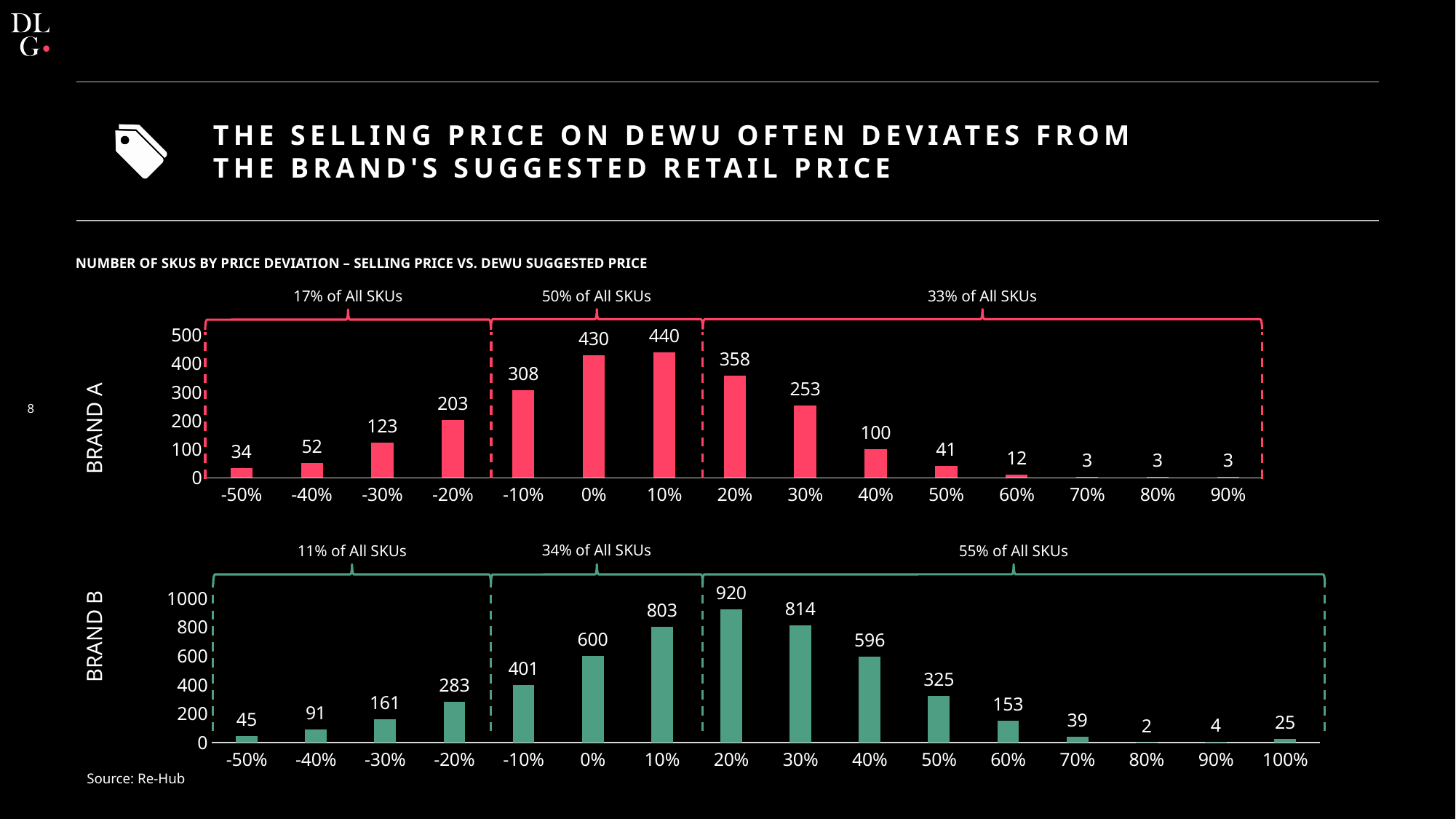
In the Brand B chart, what is the difference between the number of SKUs at 10% and at 0%? 203 In the Brand A chart, which is larger: the number of SKUs at -20% or at 30%? 30% In the Brand B chart, how many SKUs are at the 20% price deviation? 920 In the Brand A chart, which price deviation category has the highest number of SKUs? 10% In the Brand A chart, is the value for 20% greater or less than 300? greater What colour are the bars in the Brand B chart? Green In the Brand B chart, which price deviation category has the lowest number of SKUs? 80% In the Brand B chart, do the values rise or fall from 20% to 80% along the x axis? Fall What type of chart is used for Brand A? Bar chart In the Brand A chart, how many SKUs are at the 0% price deviation? 430 How many price deviation categories are shown in the Brand B chart? 16 In the Brand A chart, what share of all SKUs falls in the -10% to 10% range according to the bracket label? 50% of All SKUs